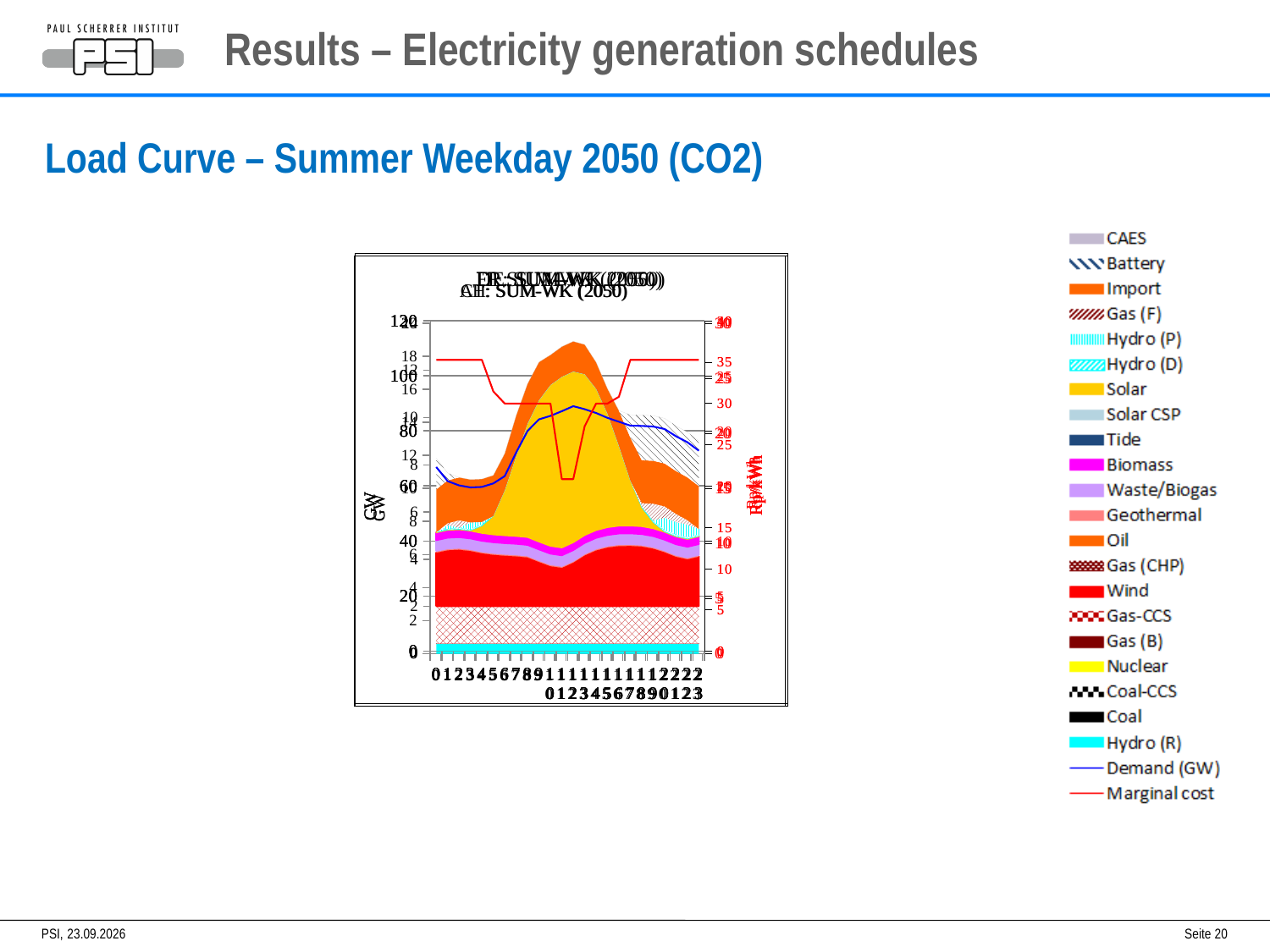
Is the Solar contribution larger at midday or at hour 0? Midday Does the Solar area rise or fall from midday towards hour 23? Fall What is the label on the left vertical axis of the chart? GW Does the Solar area rise or fall from hour 0 to the middle of the day? Rise How many entries does the legend list? 23 Does the Demand (GW) line rise or fall between hour 17 and hour 23? Fall Which legend entry is drawn as a blue line? Demand (GW) What kind of chart is shown on the slide? Stacked area chart with line series Is the Marginal cost line higher at hour 2 or at hour 12? Hour 2